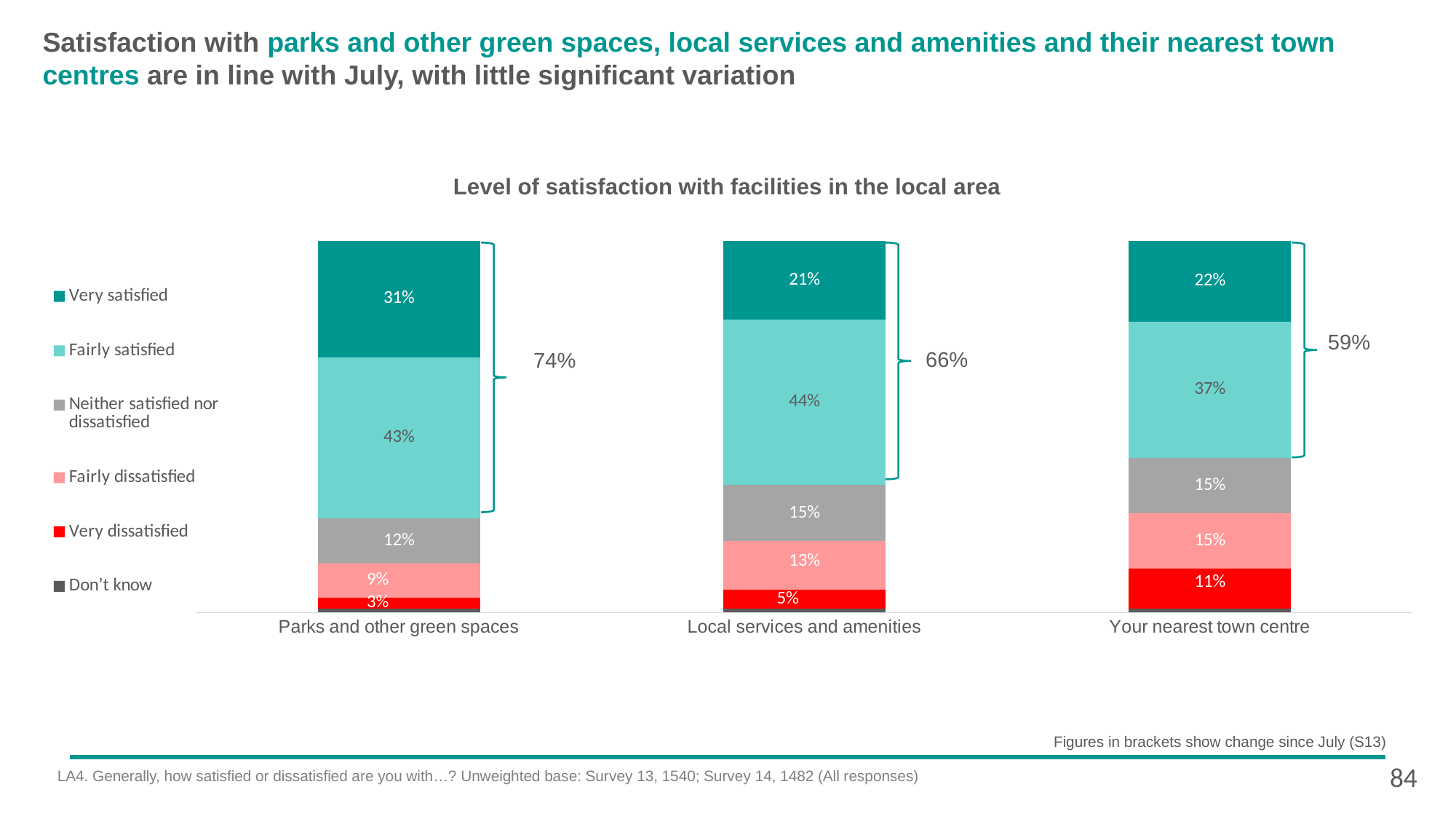
What percentage of respondents are very dissatisfied with their nearest town centre? 11% What percentage of respondents are fairly satisfied with local services and amenities? 44% Is the 'Fairly dissatisfied' percentage higher for local services and amenities or for your nearest town centre? Your nearest town centre Which facility has the lowest 'Very dissatisfied' percentage? Parks and other green spaces Which facility has the highest 'Very satisfied' percentage? Parks and other green spaces What is the combined satisfied share (very plus fairly satisfied) shown for local services and amenities? 66% What is the title of the chart? Level of satisfaction with facilities in the local area How many series does the legend list? 6 How many facility categories are shown on the x axis? 3 What percentage of respondents are very satisfied with parks and other green spaces? 31% What type of chart is shown on the slide? Stacked bar chart What is the difference between the 'Fairly satisfied' percentages for parks and other green spaces and your nearest town centre? 6 percentage points